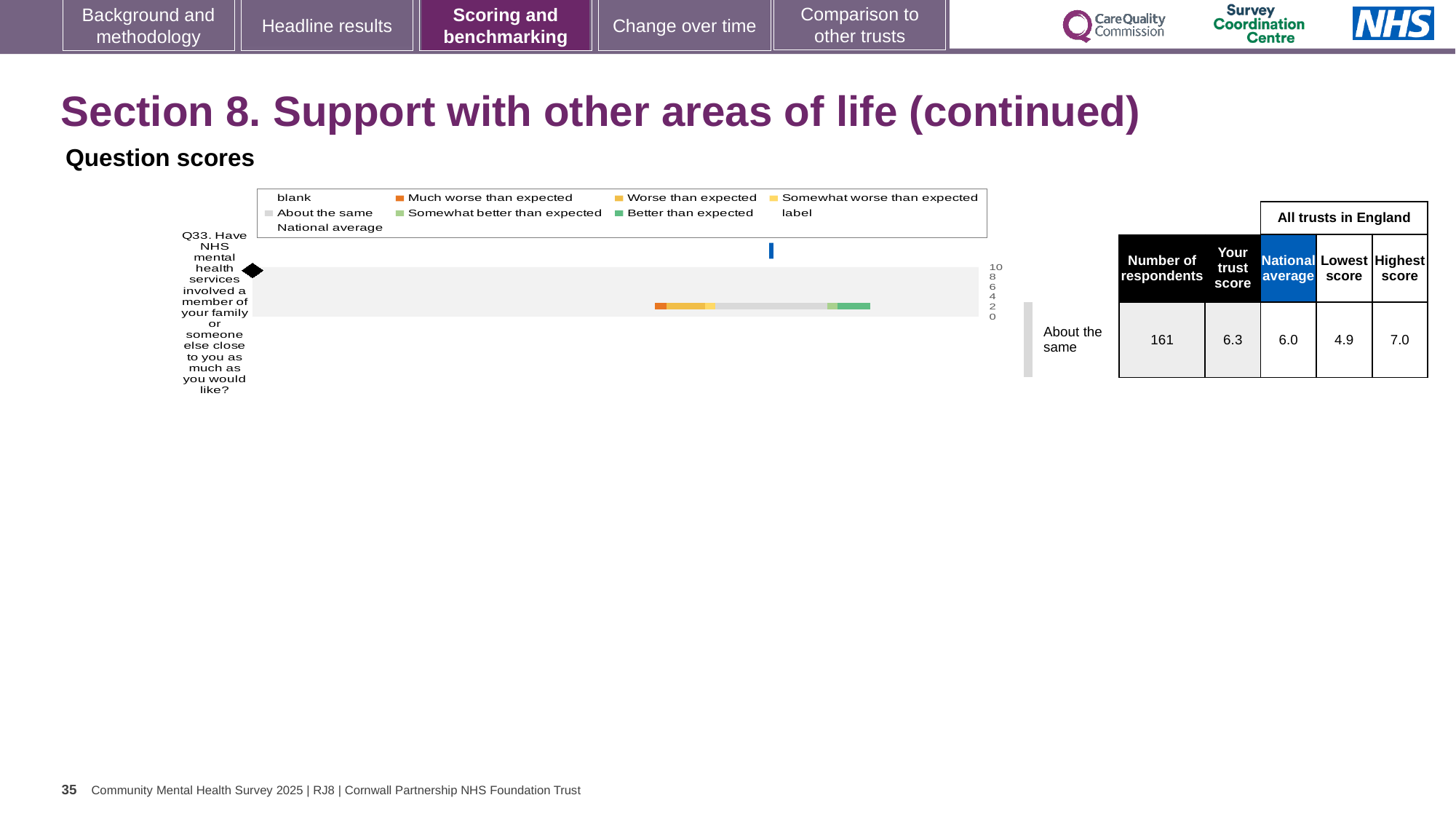
In the table next to the chart, what is the national average for Q33? 6.0 In the table next to the chart, what is the trust's score for Q33? 6.3 In the table next to the chart, what is the number of respondents for Q33? 161 Is the trust's score for Q33 larger or smaller than the national average? larger What kind of chart is shown on the slide? bar chart In the table next to the chart, what is the highest score among all trusts in England for Q33? 7.0 What is the difference between the highest score and the lowest score for Q33 shown in the table next to the chart? 2.1 Which question is plotted on the chart? Q33. Have NHS mental health services involved a member of your family or someone else close to you as much as you would like? What colour is the 'Much worse than expected' legend entry on the chart? orange How is the trust's result for Q33 categorised next to the chart? About the same In the table next to the chart, what is the lowest score among all trusts in England for Q33? 4.9 How many survey questions are plotted on the chart? 1